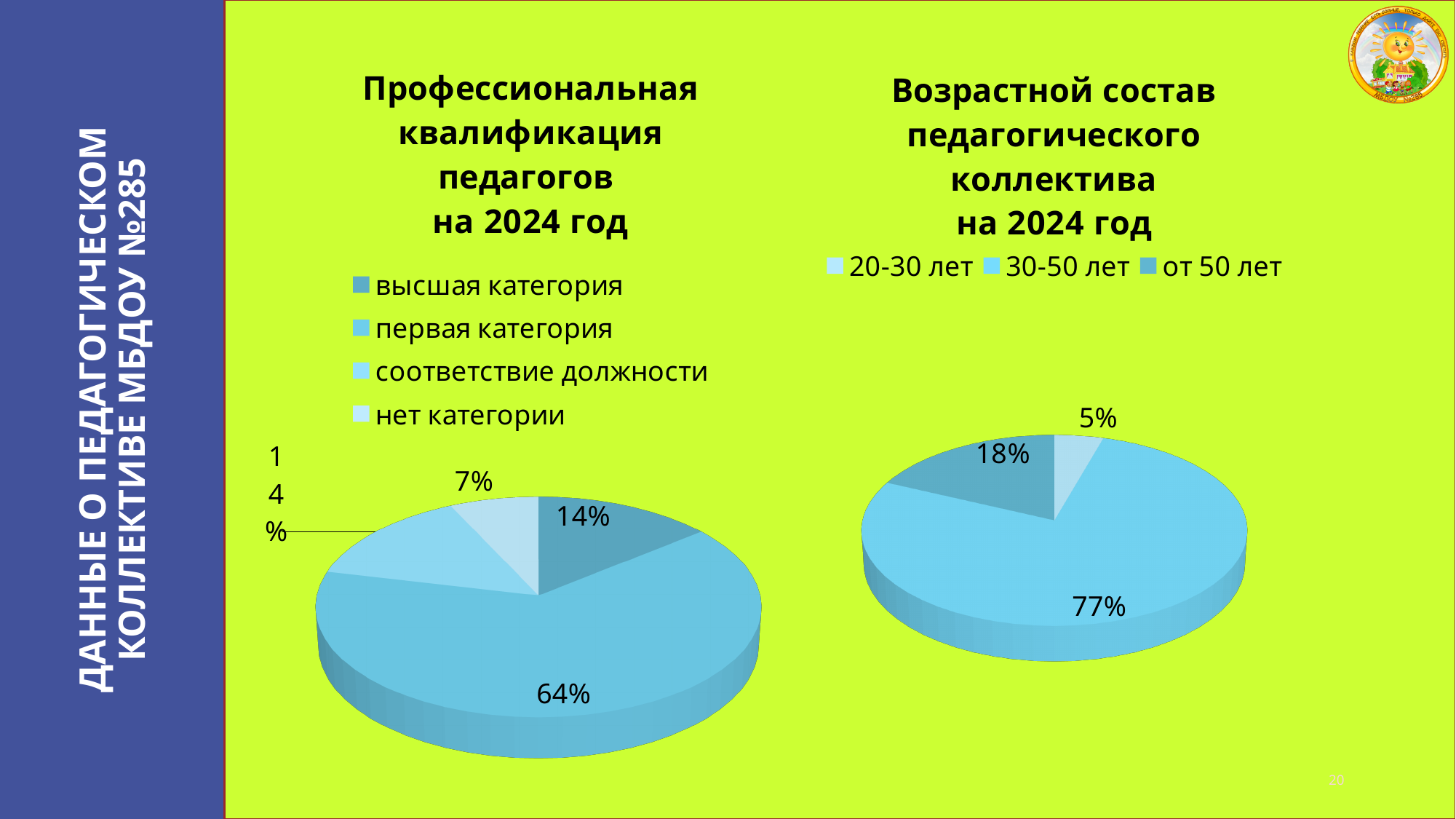
In the 'Профессиональная квалификация педагогов на 2024 год' chart, what share is 'первая категория'? 64% How many age groups does the legend of the 'Возрастной состав педагогического коллектива на 2024 год' chart list? 3 In the 'Возрастной состав педагогического коллектива на 2024 год' chart, which age group has the smallest share? 20-30 лет In the 'Возрастной состав педагогического коллектива на 2024 год' chart, what share is '20-30 лет'? 5% In the 'Возрастной состав педагогического коллектива на 2024 год' chart, what share is '30-50 лет'? 77% In the 'Возрастной состав педагогического коллектива на 2024 год' chart, what is the difference between the shares of 'от 50 лет' and '20-30 лет'? 13% In the 'Профессиональная квалификация педагогов на 2024 год' chart, what share is 'высшая категория'? 14% In the 'Профессиональная квалификация педагогов на 2024 год' chart, what share is 'соответствие должности'? 14% In the 'Профессиональная квалификация педагогов на 2024 год' chart, which category has the largest share? первая категория How many categories does the legend of the 'Профессиональная квалификация педагогов на 2024 год' chart list? 4 What kind of chart is the 'Профессиональная квалификация педагогов на 2024 год' chart? pie chart In the 'Профессиональная квалификация педагогов на 2024 год' chart, which category has the smallest share? нет категории